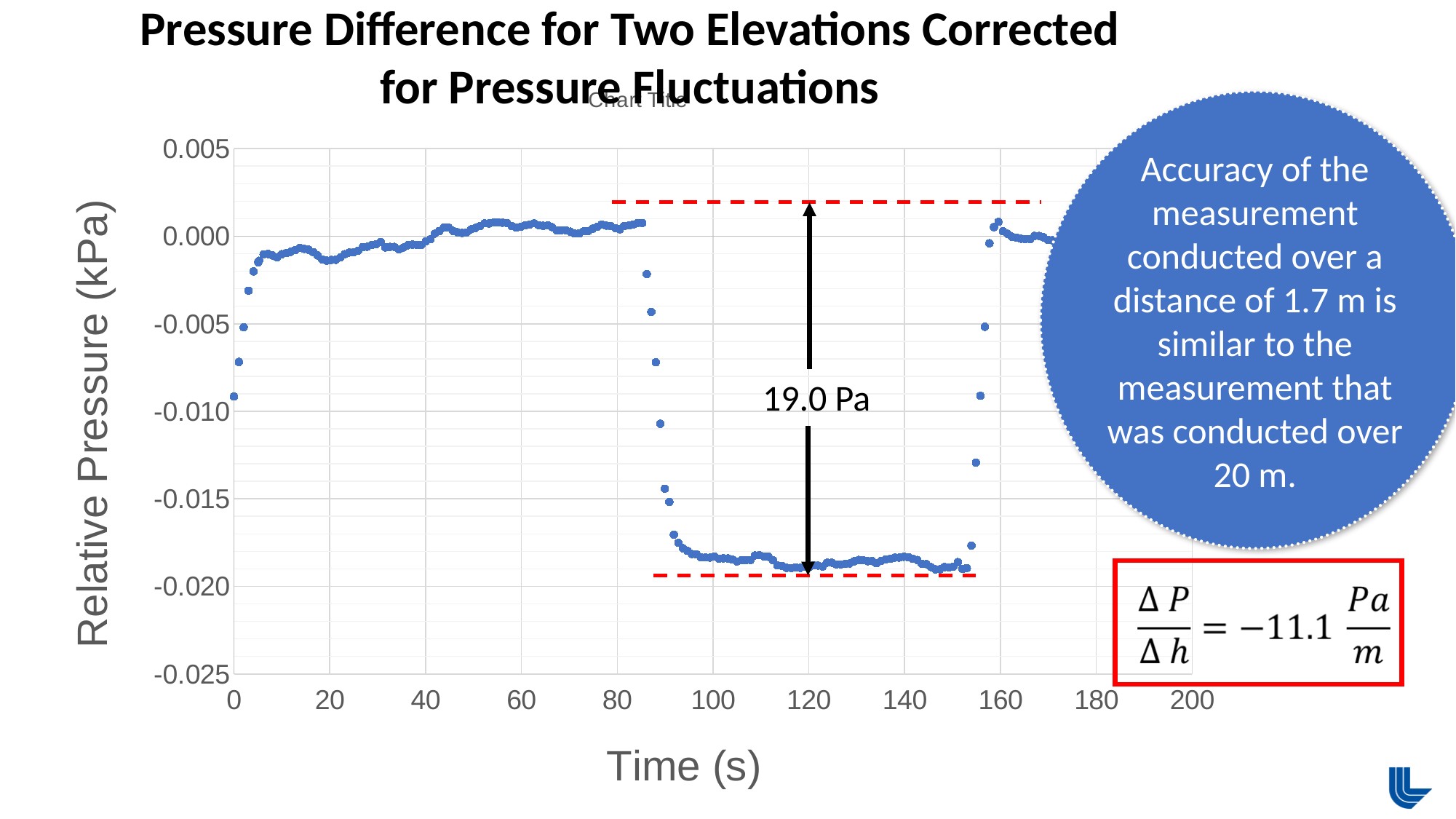
Is the relative pressure at time 40 s greater or less than -0.005? greater Do the values rise or fall between time 0 s and time 20 s? rise Which is larger, the relative pressure at time 60 s or at time 120 s? time 60 s What is the title of the slide's chart? Pressure Difference for Two Elevations Corrected for Pressure Fluctuations Is the relative pressure at time 60 s greater or less than 0.005? less What is the label of the vertical axis? Relative Pressure (kPa) What pressure difference is annotated between the two dashed lines on the chart? 19.0 Pa Is the relative pressure at time 100 s greater or less than -0.010? less What kind of chart is shown on the slide? scatter chart Do the values rise or fall between time 150 s and time 160 s? rise Do the values rise or fall between time 85 s and time 95 s? fall